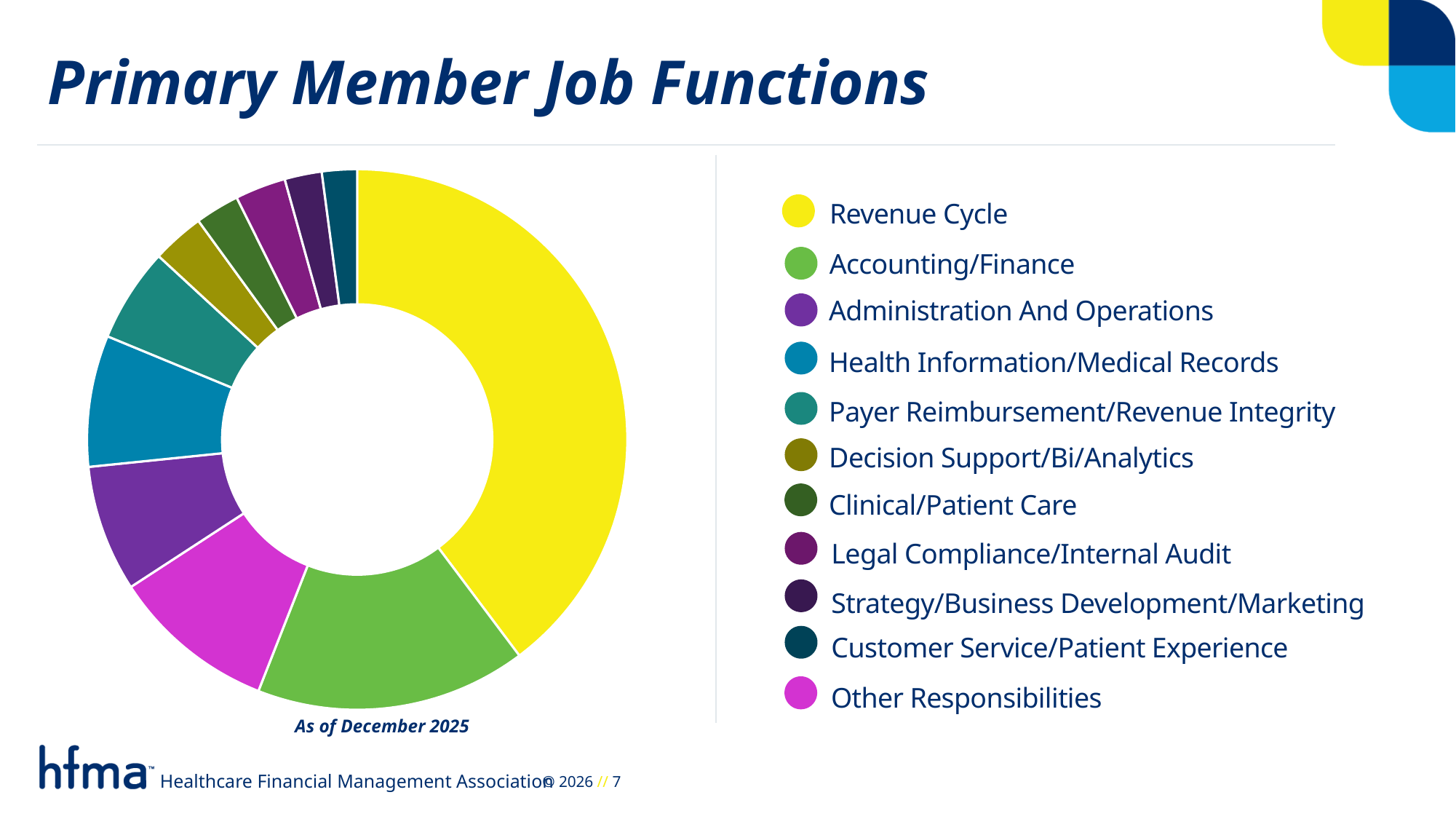
What is the title of the chart on the slide? Primary Member Job Functions Which slice is larger, Revenue Cycle or Health Information/Medical Records? Revenue Cycle How many job function categories does the chart's legend list? 11 Which slice is larger, Accounting/Finance or Other Responsibilities? Accounting/Finance Which slice is larger, Revenue Cycle or Accounting/Finance? Revenue Cycle What kind of chart is shown on the slide? Pie chart (donut) Which job function is represented by the yellow slice? Revenue Cycle Which job function has the largest slice of the chart? Revenue Cycle